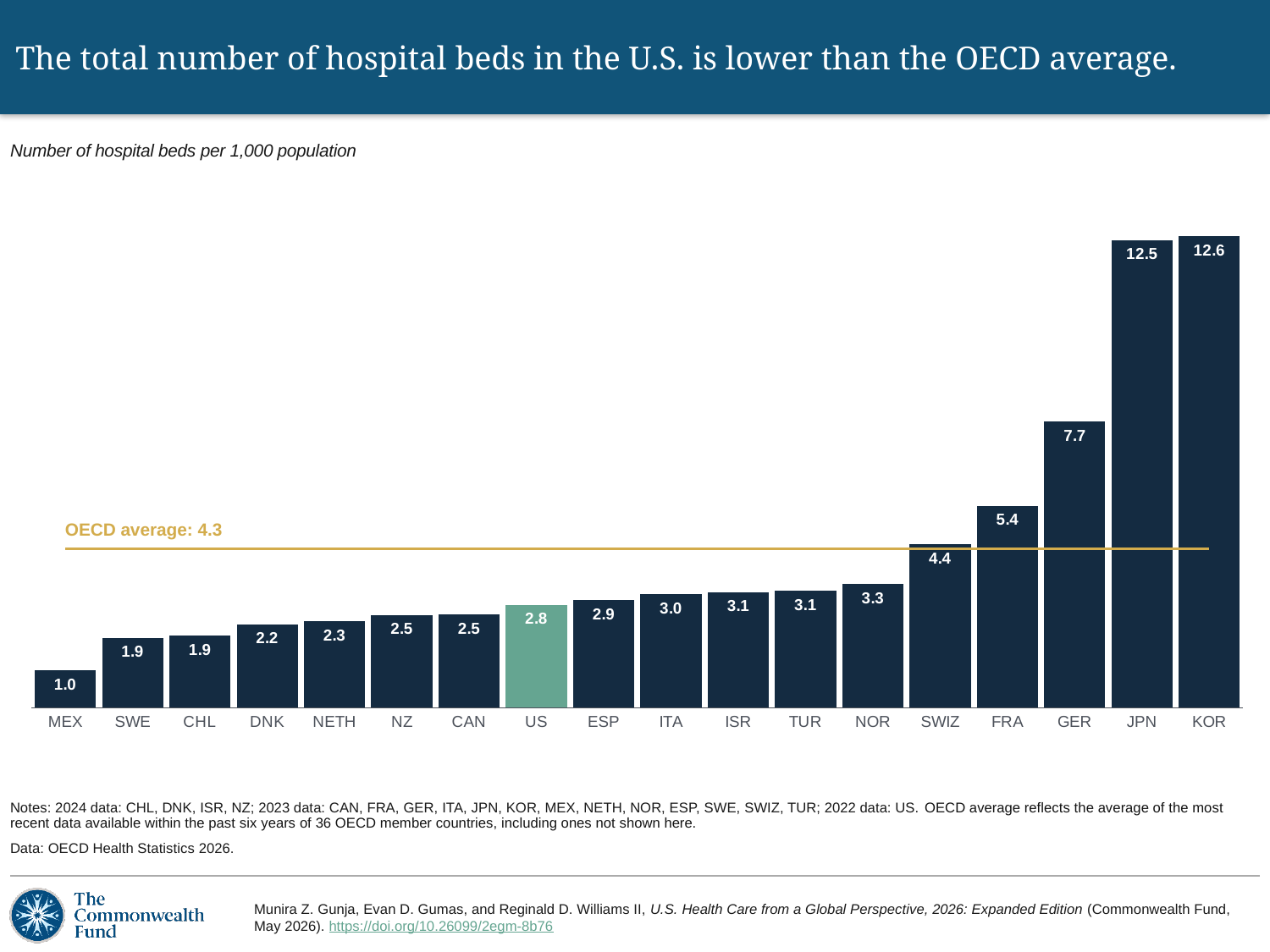
How many countries are shown in the chart? 18 What type of chart is shown on the slide? Bar chart What is the OECD average shown on the chart? 4.3 What is the difference between the US value and the OECD average? 1.5 Which country has the lowest number of hospital beds per 1,000 population? MEX Which has a higher value, FRA or NOR? FRA What is the number of hospital beds per 1,000 population for the US? 2.8 Do the values rise or fall moving from left to right along the x axis? Rise Which country has the highest number of hospital beds per 1,000 population? KOR What is the value shown for GER? 7.7 Which bar is shown in a different colour (green) from the others? US What is the difference between the values for JPN and GER? 4.8